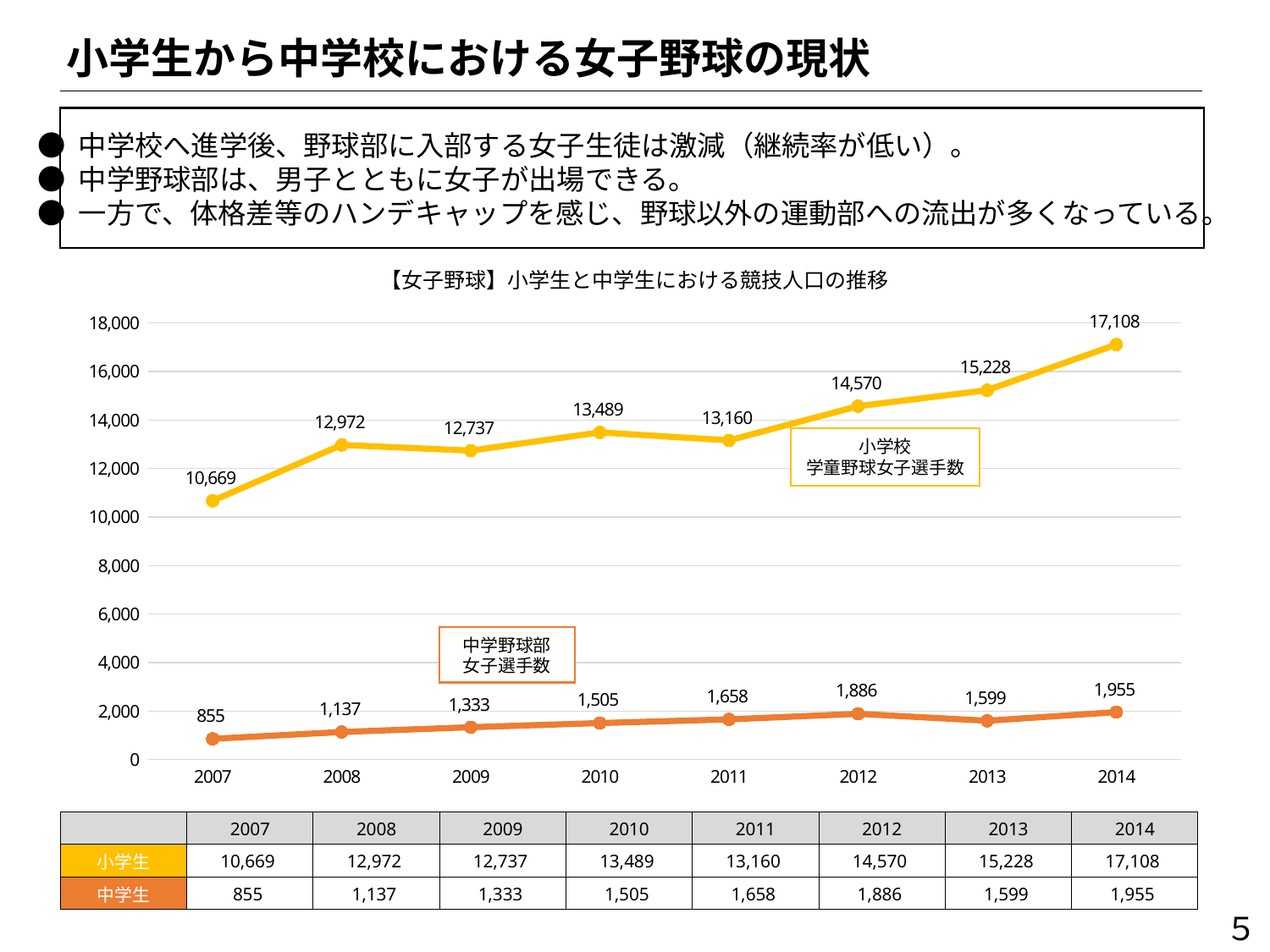
What is the difference between the 小学生 and 中学生 values in 2014? 15,153 Does the 小学生 series generally rise or fall from 2007 to 2014? rise In which year is the 小学生 value highest? 2014 How many years are plotted along the x axis of the chart? 8 How many series does the chart show? 2 What is the value for 小学生 in 2007? 10,669 What is the value for 小学生 in 2014? 17,108 Is the value for 小学生 in 2012 greater or less than 14,000? greater What type of chart is shown on the slide? line chart What is the value for 中学生 in 2012? 1,886 In which year is the 中学生 value lowest? 2007 Which is larger for 中学生: the value in 2012 or the value in 2013? 2012